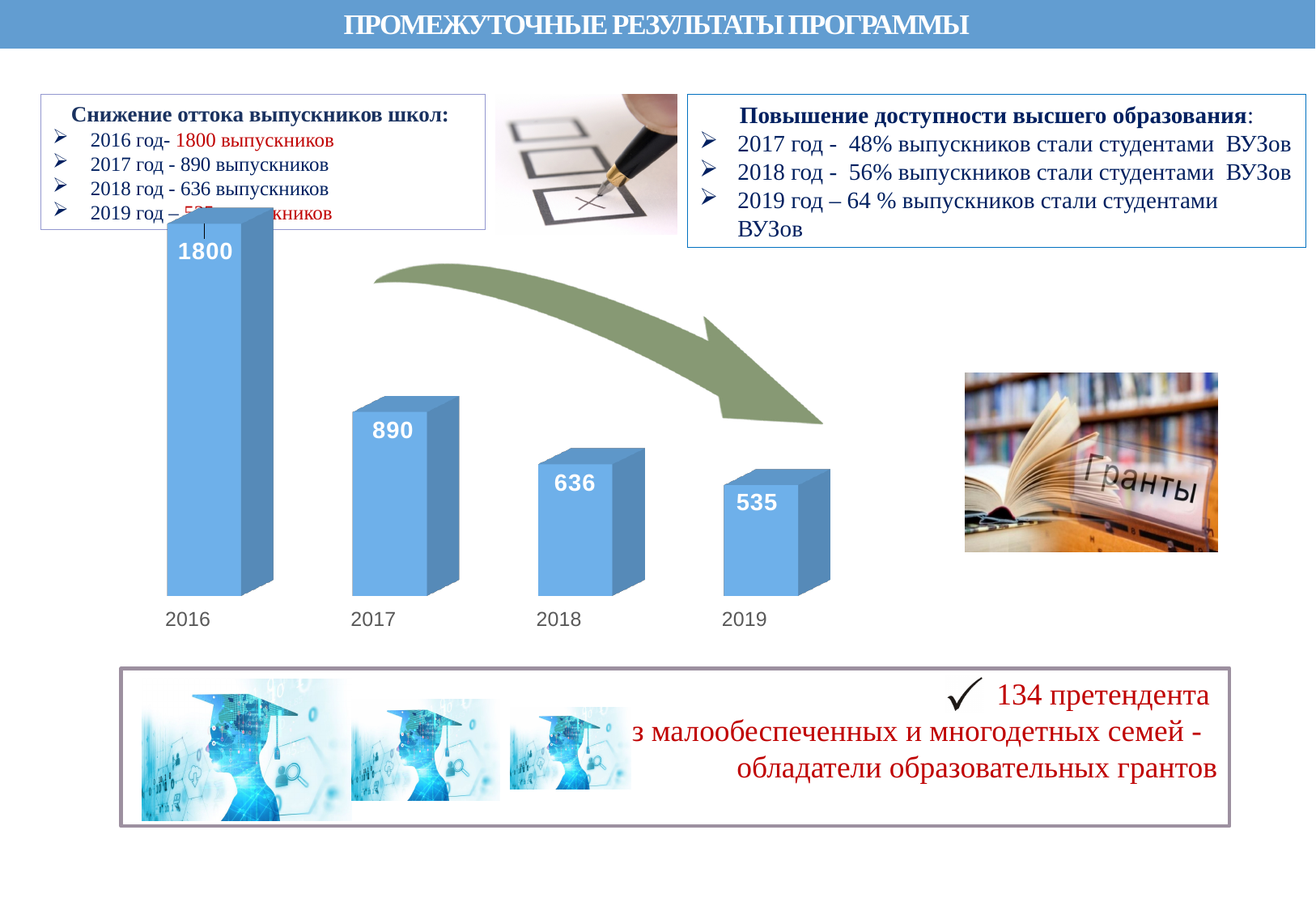
What is the difference between the values for 2016 and 2017? 910 Do the values rise or fall from 2016 to 2019? fall Which is larger, the value for 2017 or the value for 2018? 2017 Which year has the highest value in the bar chart? 2016 What is the difference between the values for 2018 and 2019? 101 How many years are shown in the bar chart? 4 What is the value for 2016 in the bar chart? 1800 What kind of chart is shown on the slide? bar chart Which year has the lowest value in the bar chart? 2019 What is the value for 2019 in the bar chart? 535 What is the value for 2018 in the bar chart? 636 What is the value for 2017 in the bar chart? 890